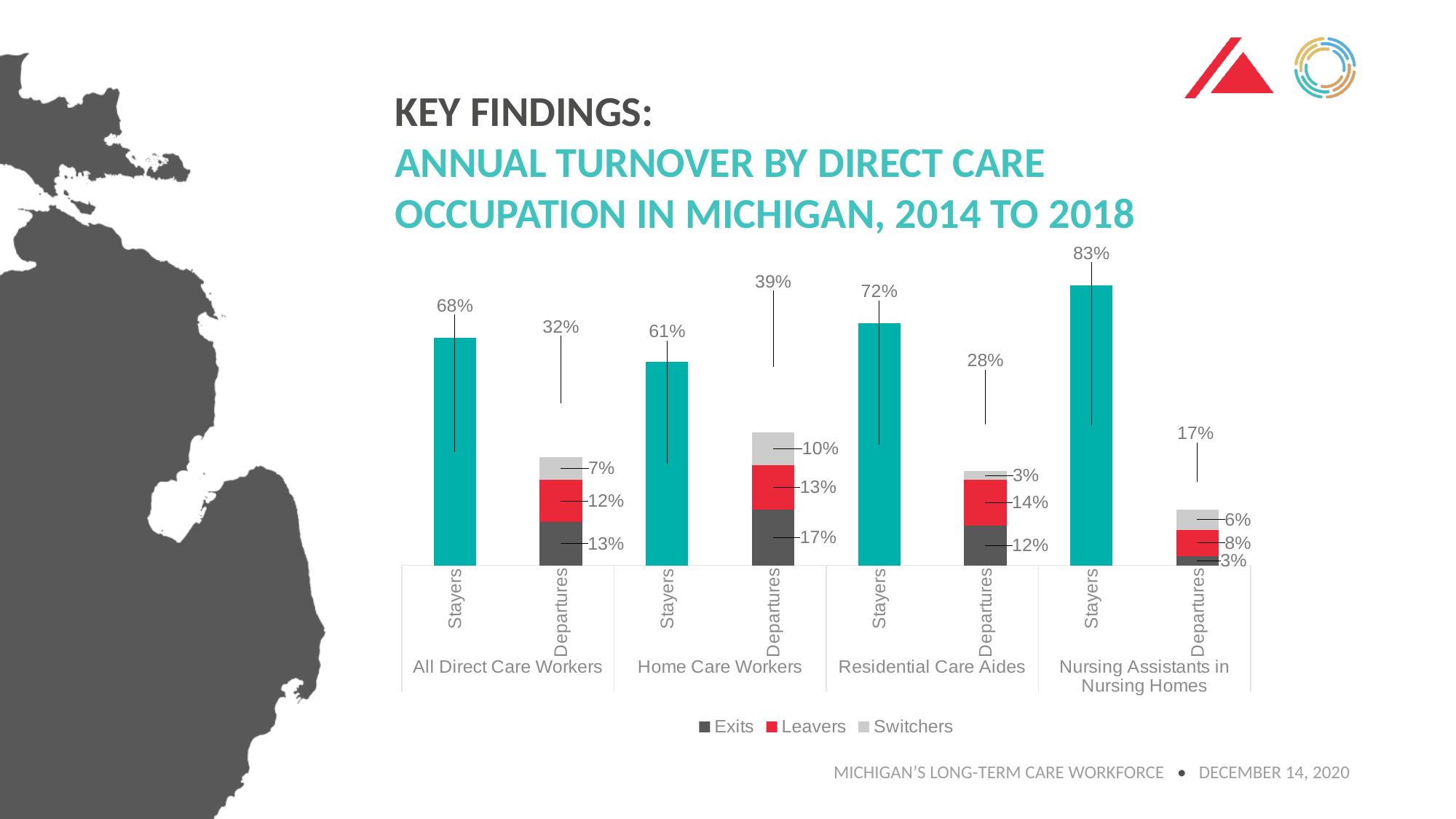
Which is larger: the Leavers value for Residential Care Aides or the Leavers value for Nursing Assistants in Nursing Homes? Residential Care Aides What is the Switchers value in the Departures bar for Residential Care Aides? 3% What is the total Departures value for Home Care Workers? 39% What is the difference between the Stayers values for Nursing Assistants in Nursing Homes and Home Care Workers? 22% What is the Stayers value for Nursing Assistants in Nursing Homes? 83% What kind of chart is shown on the slide? Stacked bar chart What is the Leavers value in the Departures bar for All Direct Care Workers? 12% Which occupation has the lowest Stayers value? Home Care Workers How many series does the legend list? 3 How many occupation groups are shown on the x axis? 4 What is the Exits value in the Departures bar for Home Care Workers? 17% Which occupation has the highest Stayers value? Nursing Assistants in Nursing Homes